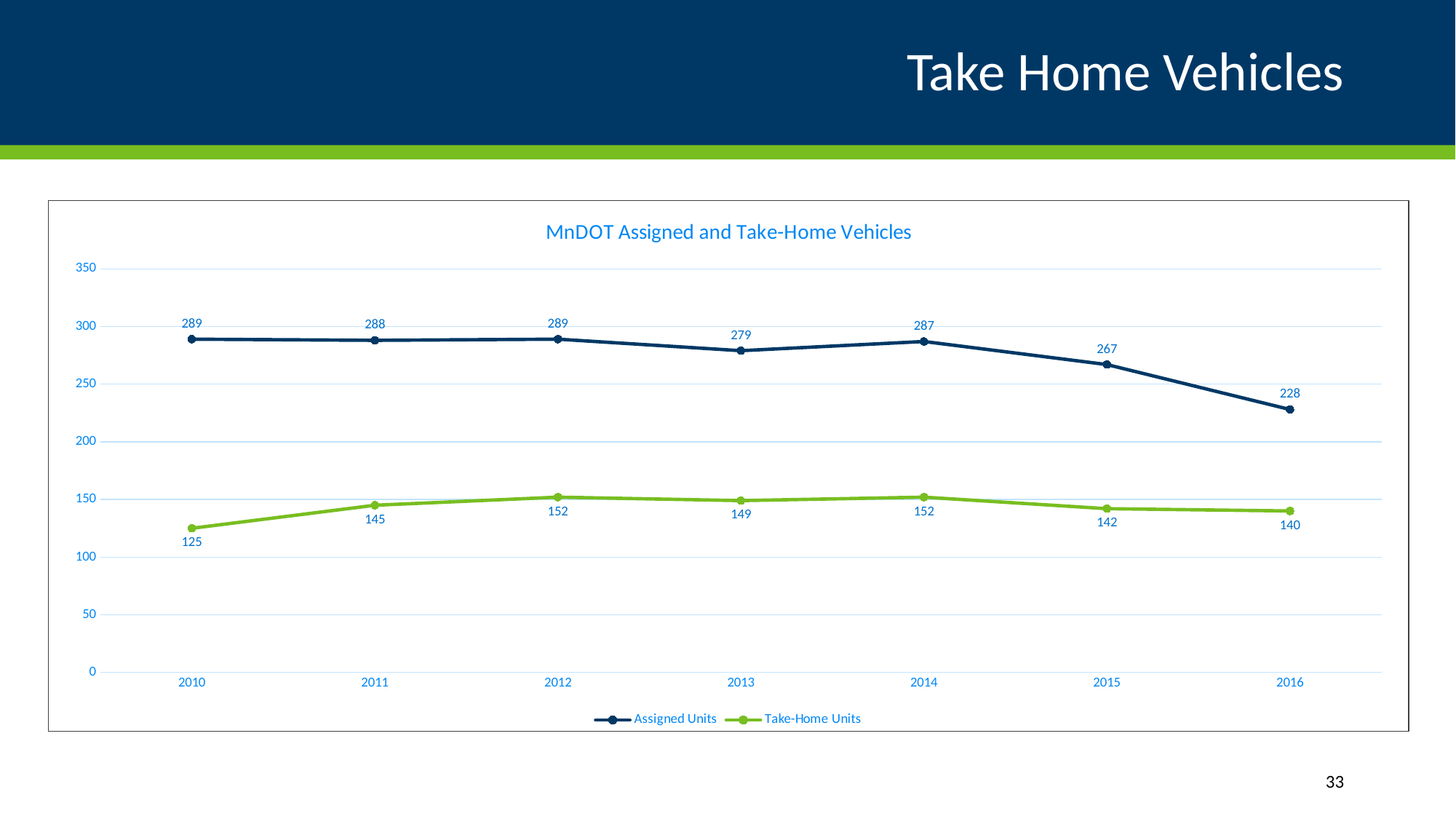
What is the difference between Assigned Units and Take-Home Units in 2016? 88 What kind of chart is shown on the slide? Line chart How many series does the legend list? 2 What is the value for Assigned Units in 2016? 228 What is the value for Assigned Units in 2013? 279 In which year is the Assigned Units value lowest? 2016 Which is larger, Take-Home Units in 2011 or Take-Home Units in 2015? 2011 How many years are shown on the x axis? 7 In which year is the Take-Home Units value lowest? 2010 What is the value for Take-Home Units in 2010? 125 What is the difference between Assigned Units in 2010 and in 2016? 61 Is the value for Assigned Units in 2015 greater or less than 250? greater